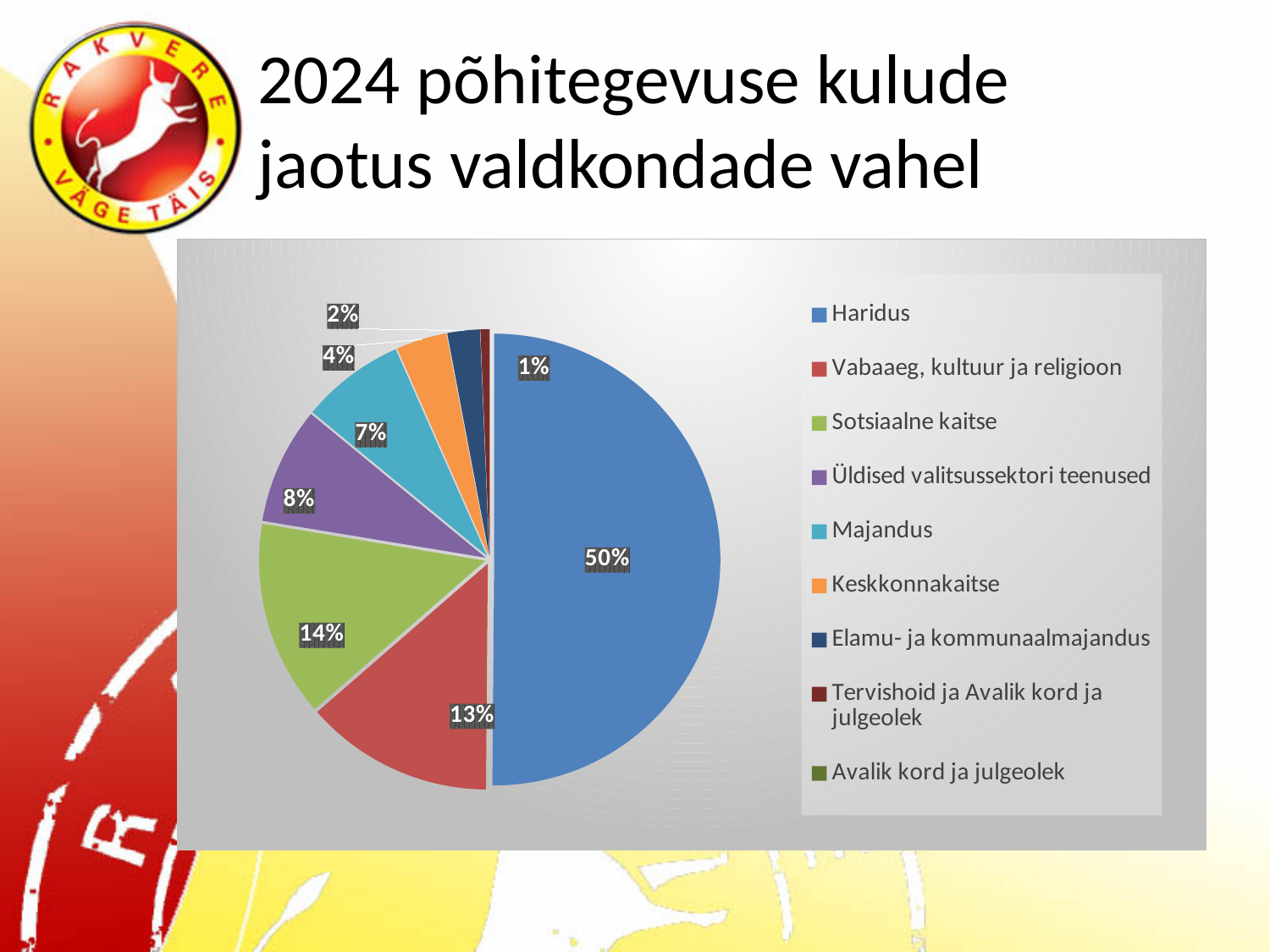
Which category has the largest slice of the pie? Haridus What percentage is shown for Majandus? 7% What share of the pie does Haridus have? 50% What percentage is shown for Sotsiaalne kaitse? 14% What percentage is shown for Vabaaeg, kultuur ja religioon? 13% How many percentage points larger is the Haridus share than the Sotsiaalne kaitse share? 36 What is the title of the slide? 2024 põhitegevuse kulude jaotus valdkondade vahel What kind of chart is shown on the slide? pie chart How many entries does the legend list? 9 What percentage is shown for Keskkonnakaitse? 4% What percentage is shown for Üldised valitsussektori teenused? 8% Which is larger, the share for Sotsiaalne kaitse or the share for Vabaaeg, kultuur ja religioon? Sotsiaalne kaitse